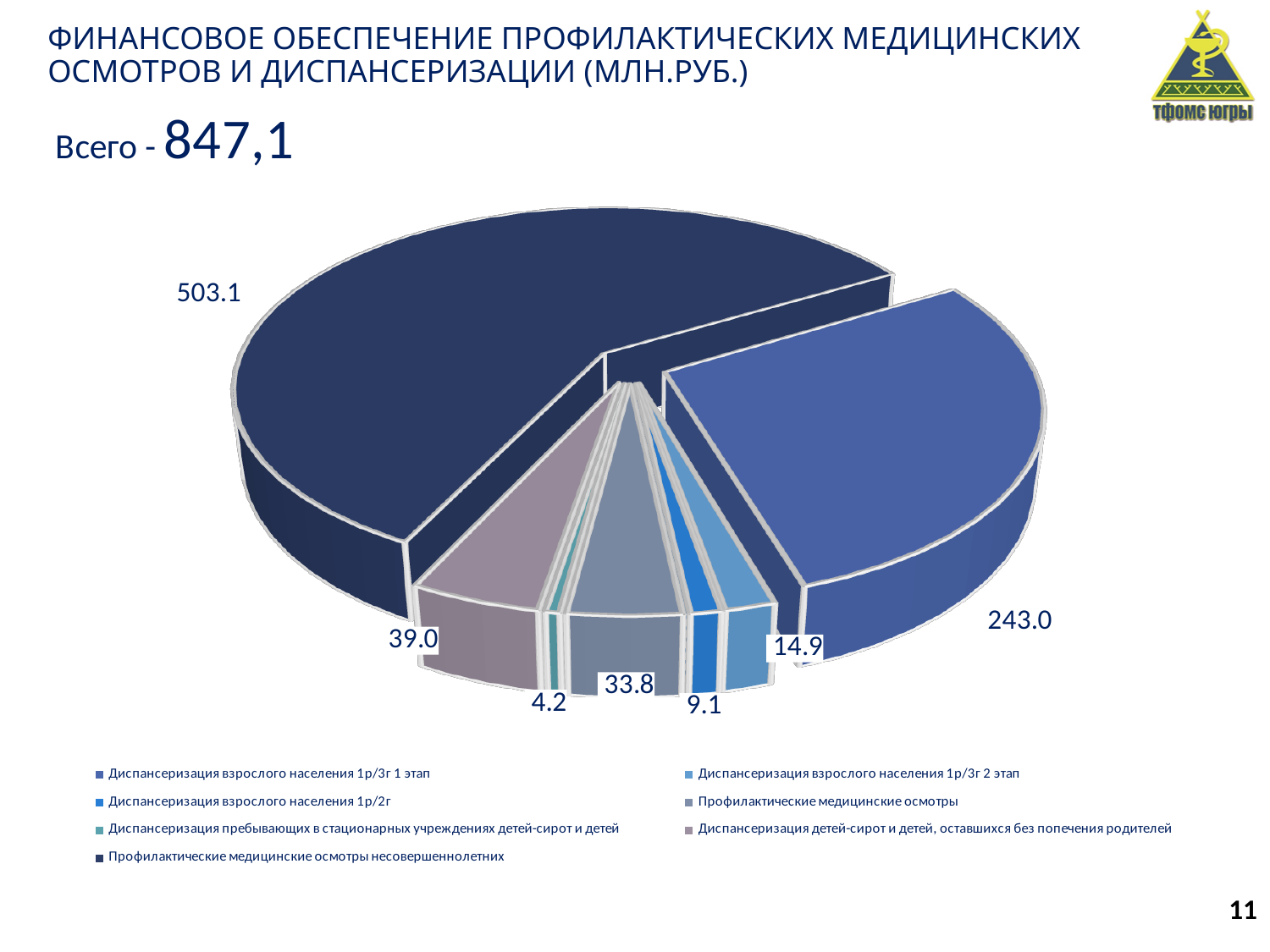
What is the value of the smallest slice of the pie chart? 4.2 What is the value of the second-largest slice of the pie chart? 243.0 What share of the total 847,1 does the largest slice (503.1) represent, to one decimal place? 59.4% How many entries does the legend list? 7 What total (Всего) is stated on the slide for the pie chart? 847,1 How many slices does the pie chart have? 7 What kind of chart is shown on the slide? pie chart In what units are the values in the chart expressed, according to the slide title? млн.руб. What is the difference between the largest slice (503.1) and the second-largest slice (243.0)? 260.1 What is the value of the largest slice of the pie chart? 503.1 Which is larger, the slice labelled 14.9 or the slice labelled 9.1? 14.9 What is the difference between the slices labelled 39.0 and 33.8? 5.2